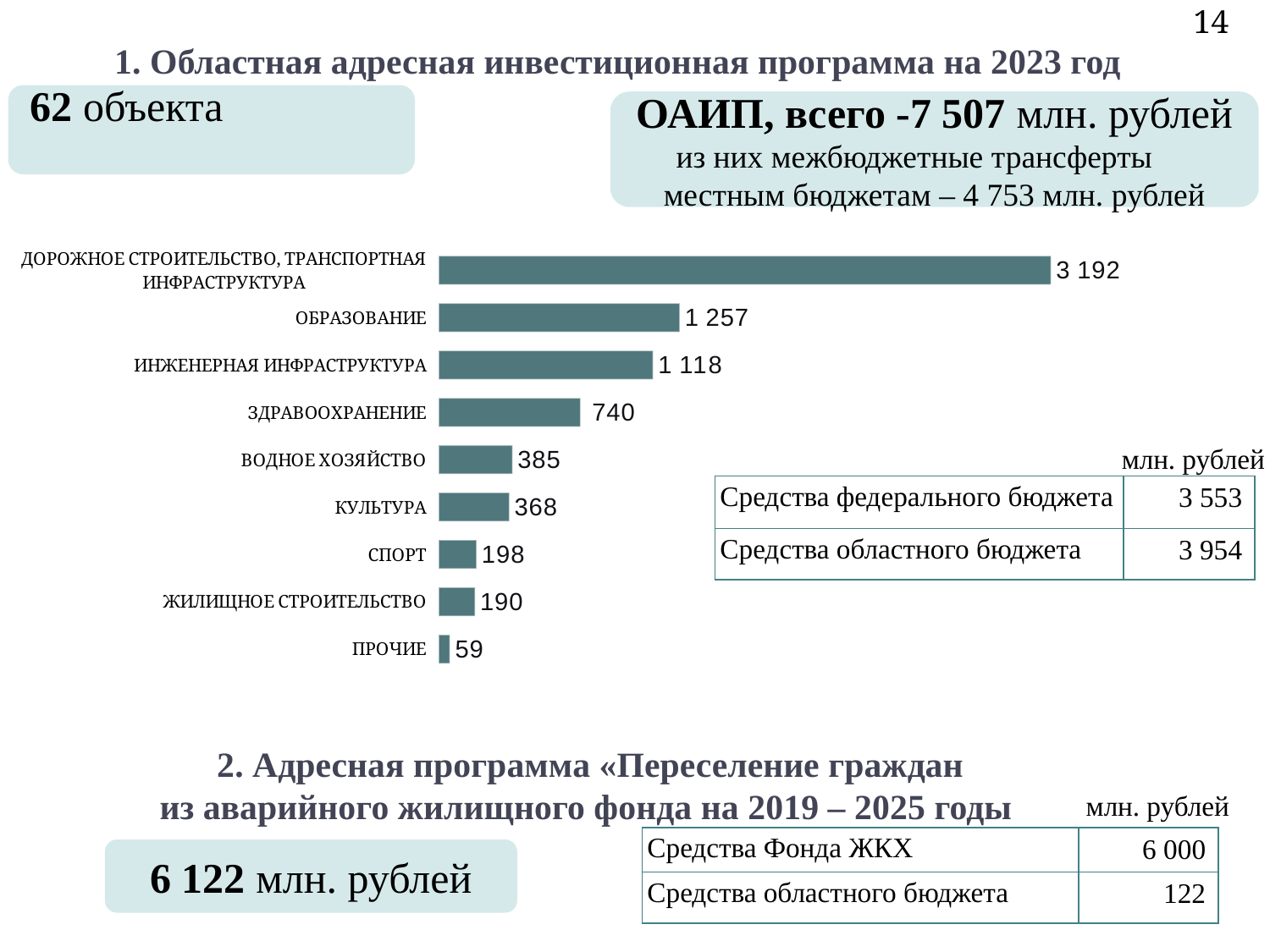
What is the value for ЖИЛИЩНОЕ СТРОИТЕЛЬСТВО in the bar chart? 190 What is the value for ДОРОЖНОЕ СТРОИТЕЛЬСТВО, ТРАНСПОРТНАЯ ИНФРАСТРУКТУРА in the bar chart? 3 192 What is the difference between the values for ОБРАЗОВАНИЕ and ИНЖЕНЕРНАЯ ИНФРАСТРУКТУРА? 139 What is the value for ОБРАЗОВАНИЕ in the bar chart? 1 257 Which is larger in the bar chart: the value for ЗДРАВООХРАНЕНИЕ or the value for ИНЖЕНЕРНАЯ ИНФРАСТРУКТУРА? ИНЖЕНЕРНАЯ ИНФРАСТРУКТУРА Which category has the highest value in the bar chart? ДОРОЖНОЕ СТРОИТЕЛЬСТВО, ТРАНСПОРТНАЯ ИНФРАСТРУКТУРА What is the value for ЗДРАВООХРАНЕНИЕ in the bar chart? 740 What kind of chart is shown on the slide? Bar chart Which category has the lowest value in the bar chart? ПРОЧИЕ Which is larger in the bar chart: the value for СПОРТ or the value for ЖИЛИЩНОЕ СТРОИТЕЛЬСТВО? СПОРТ What is the difference between the values for ВОДНОЕ ХОЗЯЙСТВО and КУЛЬТУРА? 17 How many categories are shown in the bar chart? 9